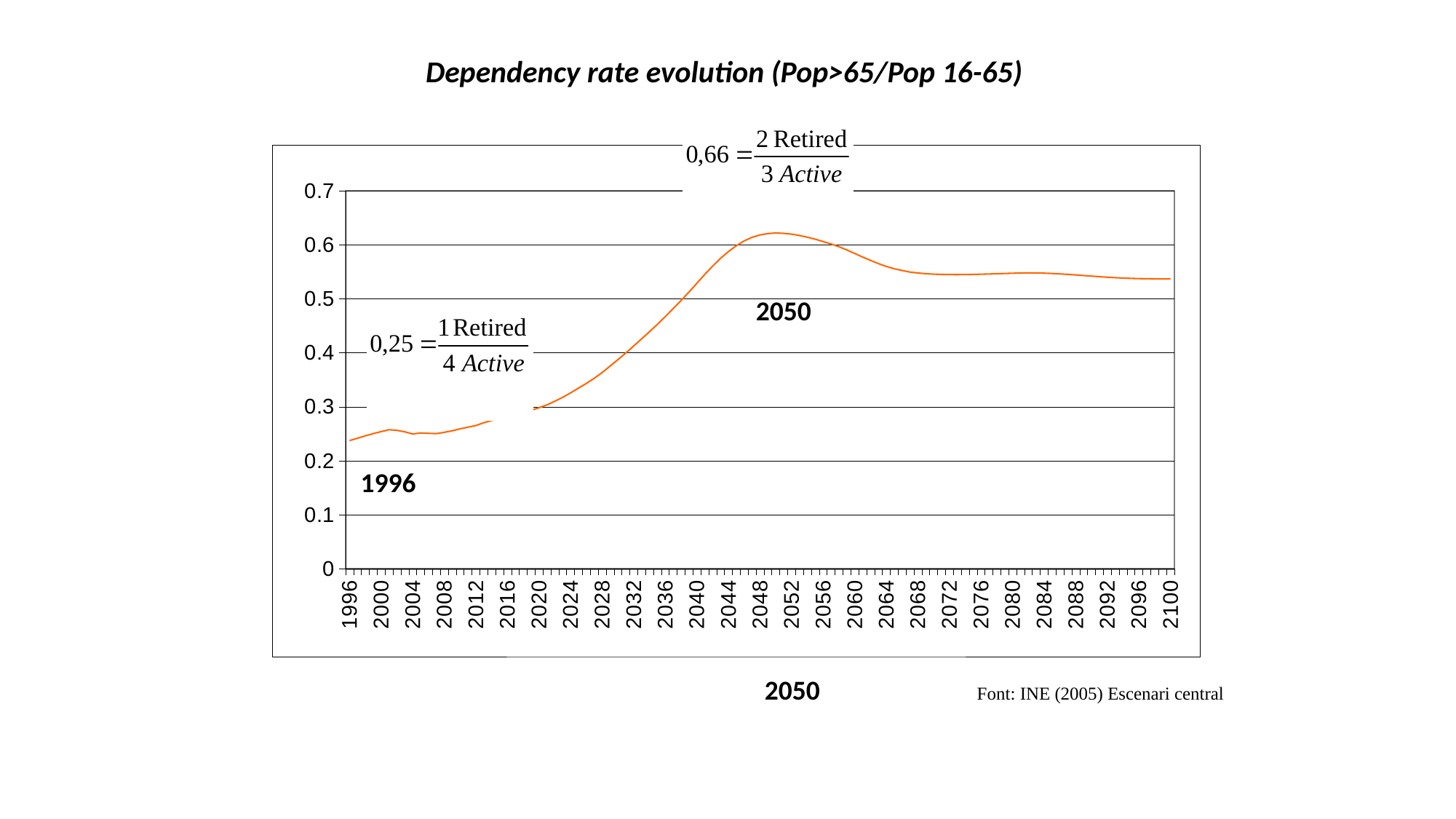
Is the dependency rate in 1996 greater or less than 0.2? greater Around which year does the dependency rate reach its highest value? 2050 Does the dependency rate rise or fall between 2050 and 2068? fall Is the dependency rate in 2028 greater or less than 0.3? greater Is the dependency rate in 1996 greater or less than 0.3? less What is the title of the chart? Dependency rate evolution (Pop>65/Pop 16-65) What kind of chart is shown on the slide? line chart Does the dependency rate rise or fall between 2020 and 2048? rise Which year has a higher dependency rate, 1996 or 2100? 2100 What source is cited below the chart? INE (2005) Escenari central